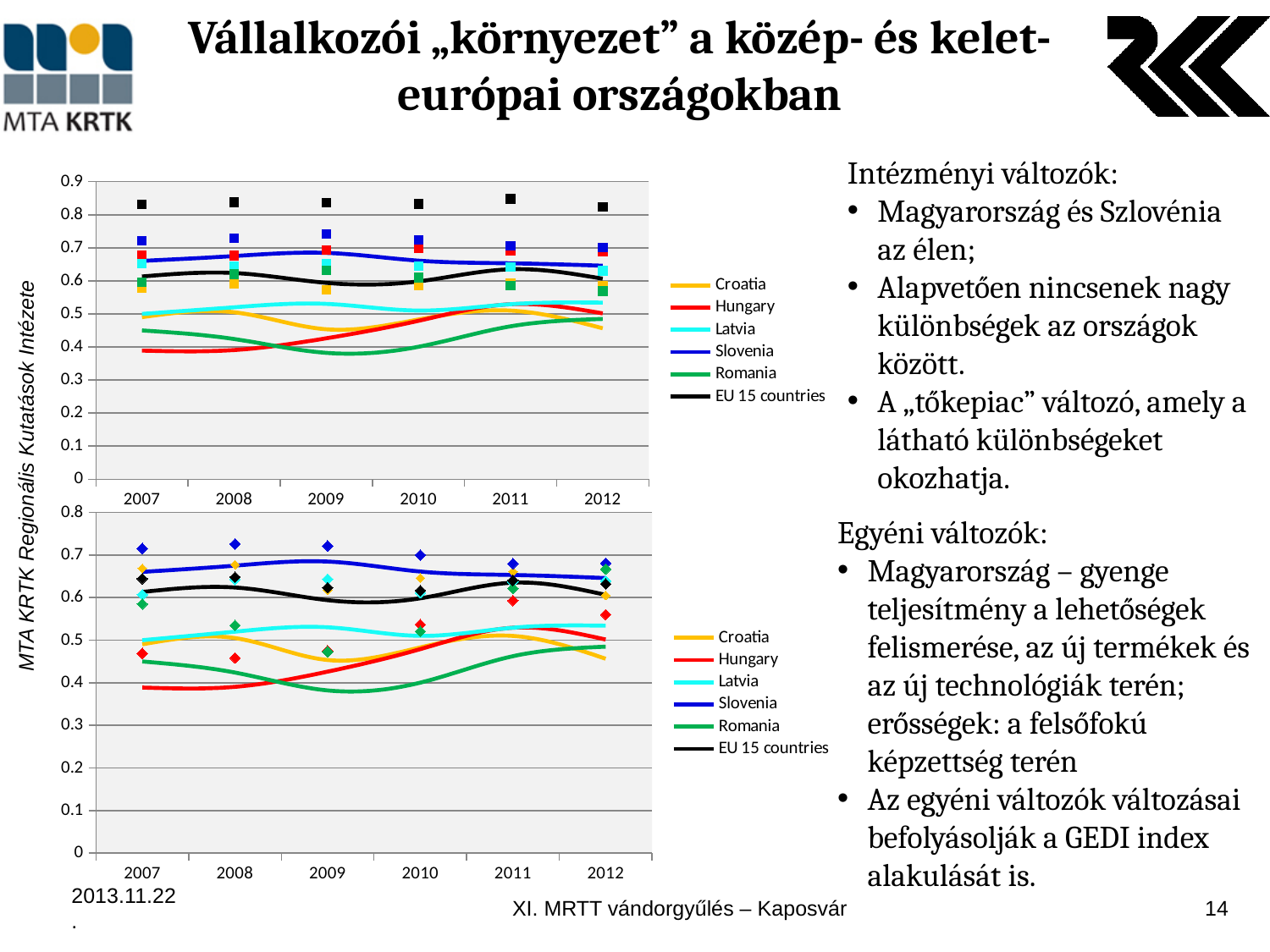
What kind of chart is the top chart on the slide? line chart In the bottom chart, what is the highest value shown on the y axis? 0.8 In the bottom chart, which is larger in 2007, Slovenia or Romania? Slovenia In the top chart, is the value for Slovenia in 2009 greater or less than 0.6? greater In the top chart, does the Hungary line rise or fall from 2007 to 2011? rise In the top chart, how many years are shown on the x axis? 6 In the bottom chart, how many series does the legend list? 6 In the bottom chart, which is larger in 2012, Slovenia or Croatia? Slovenia In the top chart, which series is listed last in the legend? EU 15 countries In the bottom chart, is the value for Slovenia in 2008 greater or less than 0.6? greater In the bottom chart, does the Hungary line rise or fall from 2007 to 2011? rise What kind of chart is the bottom chart on the slide? line chart